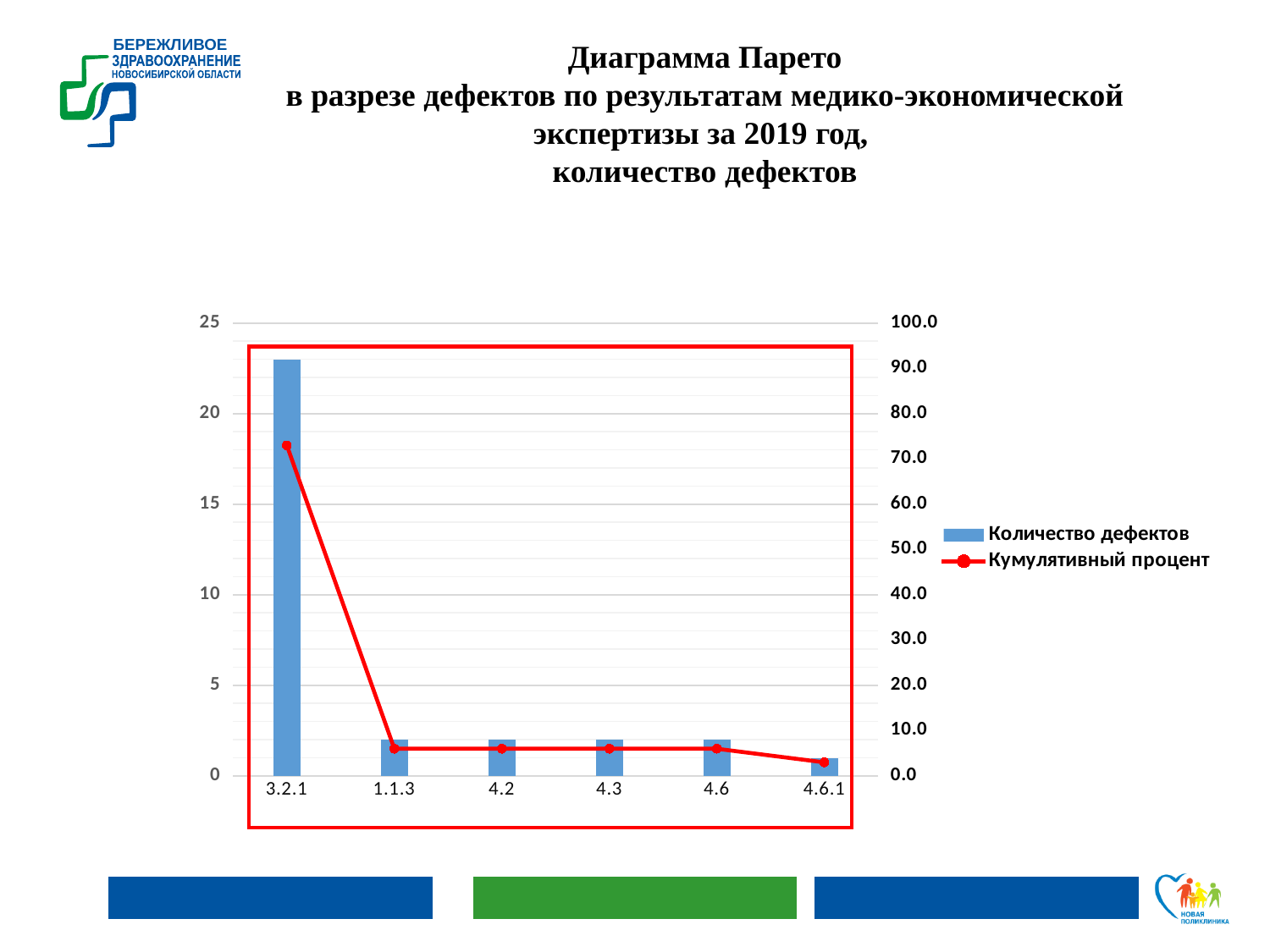
Is the cumulative percent value for category 4.6.1 greater or less than 10.0? less Which has more defects, category 3.2.1 or category 4.6.1? 3.2.1 Is the number of defects for category 1.1.3 greater or less than 5? less How many defect categories are shown on the x axis? 6 Is the cumulative percent value for category 3.2.1 greater or less than 60.0? greater What are the two series named in the legend? Количество дефектов and Кумулятивный процент How many series does the legend list? 2 Which defect category has the lowest number of defects? 4.6.1 What kind of chart is shown on the slide? Combined bar and line chart Do the bar values rise or fall from left to right along the x axis? fall Which defect category has the highest number of defects? 3.2.1